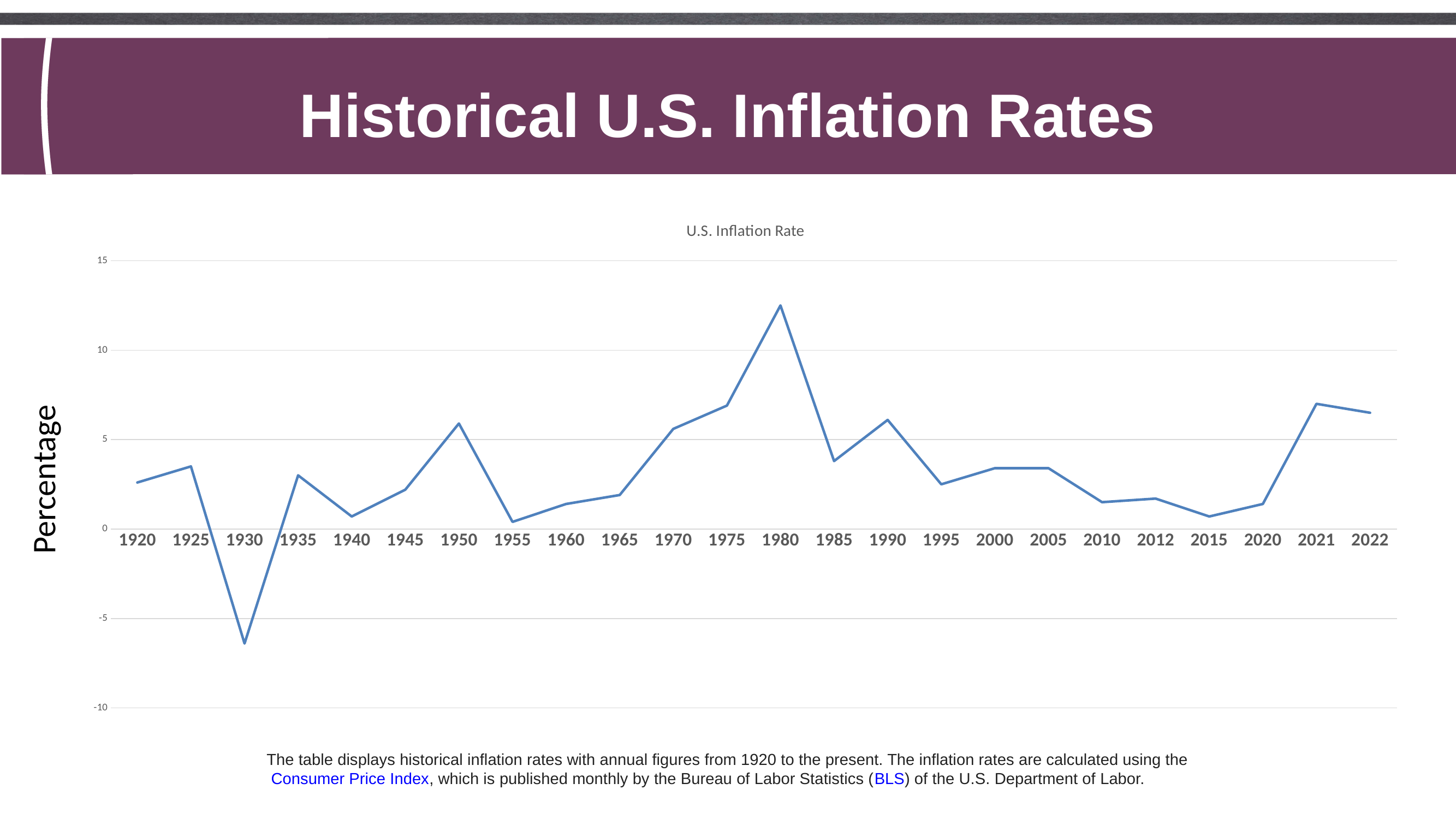
Which year has the larger inflation rate, 1950 or 1955? 1950 Which year has the highest inflation rate on the chart? 1980 Does the inflation rate rise or fall between 1980 and 1985? fall What kind of chart is shown on the slide? line chart Is the value for 1985 greater or less than 5? less Is the value for 1980 greater or less than 10? greater Is the value for 1930 greater or less than -5? less How many years are plotted along the x axis of the chart? 24 What is the title of the chart? U.S. Inflation Rate What is the label on the vertical axis of the chart? Percentage Which year has the lowest inflation rate on the chart? 1930